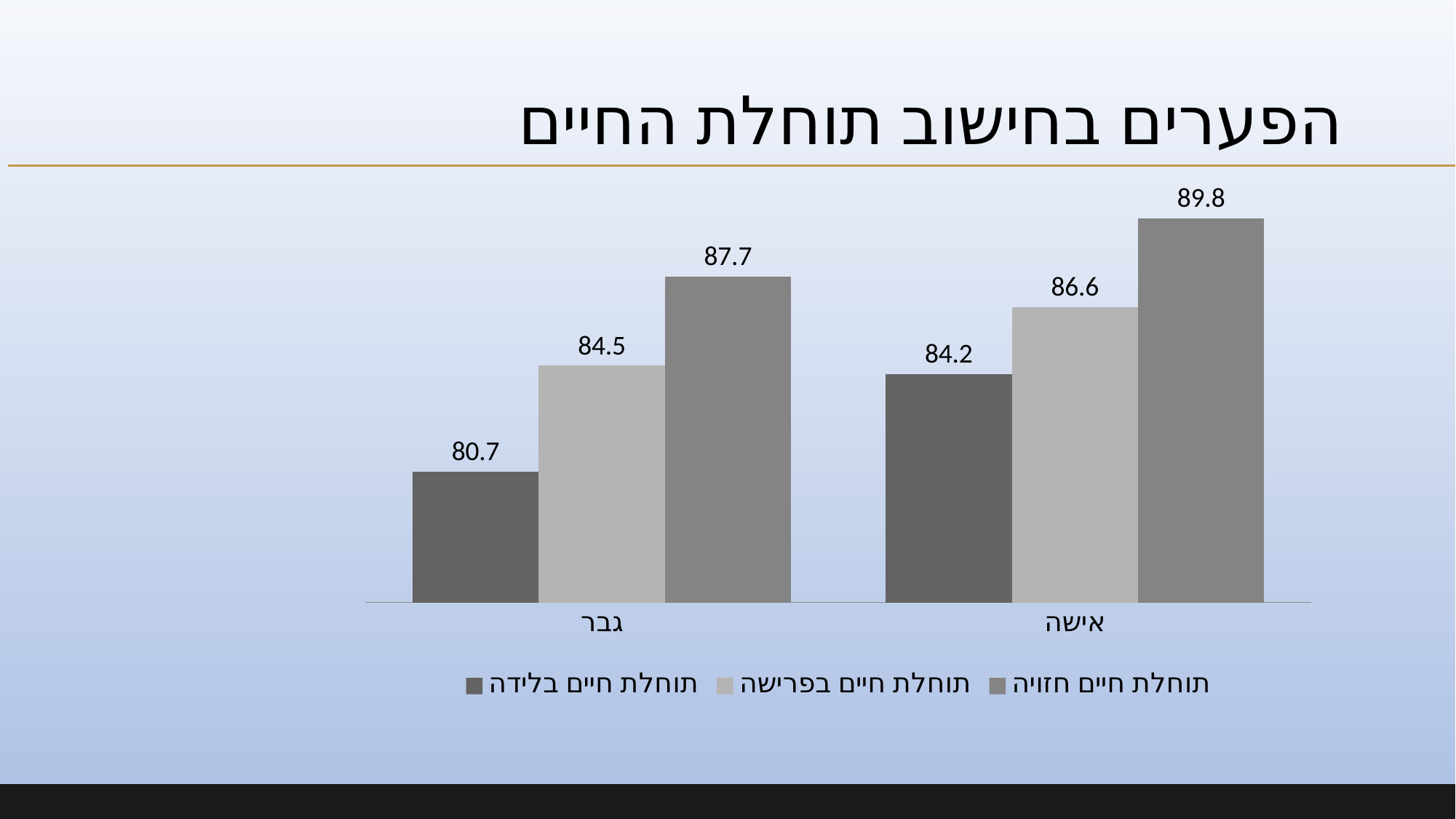
What is the value of תוחלת חיים חזויה for אישה? 89.8 What is the value of תוחלת חיים בפרישה for אישה? 86.6 How many series does the legend list? 3 What is the difference between תוחלת חיים חזויה and תוחלת חיים בלידה for גבר? 7.0 Which bar has the lowest value on the chart? תוחלת חיים בלידה for גבר (80.7) What is the value of תוחלת חיים בלידה for גבר? 80.7 What is the value of תוחלת חיים חזויה for גבר? 87.7 How many categories are shown on the x axis? 2 Which bar has the highest value on the chart? תוחלת חיים חזויה for אישה (89.8) Which is larger: תוחלת חיים בפרישה for גבר or תוחלת חיים בלידה for אישה? תוחלת חיים בפרישה for גבר What type of chart is shown on the slide? Bar chart What is the difference between the תוחלת חיים בלידה values for אישה and גבר? 3.5